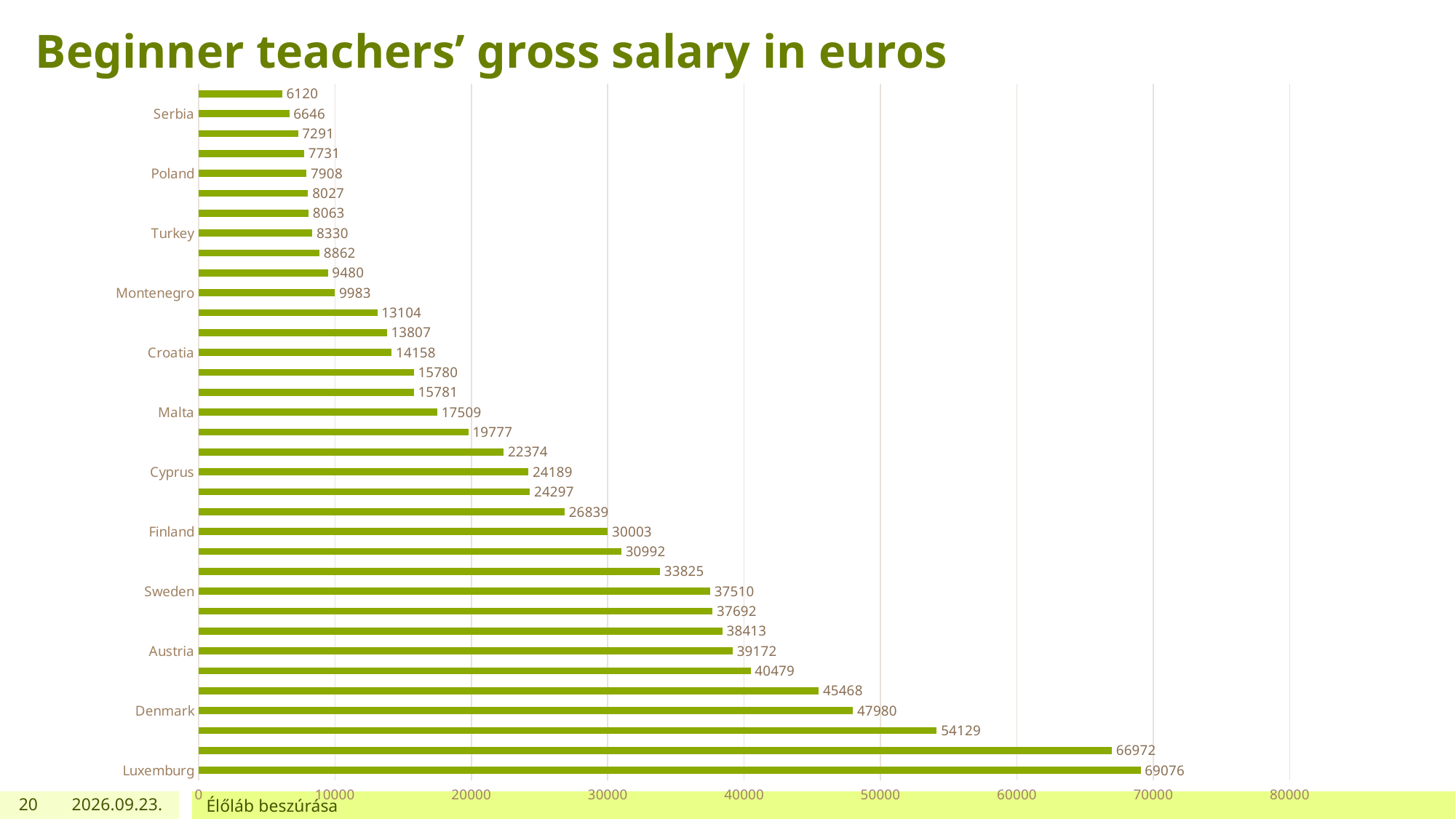
What is the beginner teachers' gross salary in euros for Luxemburg? 69076 What is the smallest value shown on the chart? 6120 What type of chart is shown on the slide? bar chart What is the title of the chart? Beginner teachers' gross salary in euros Which labelled country has the highest beginner teachers' gross salary? Luxemburg Which has a higher value, Cyprus or Malta? Cyprus What is the value shown for Serbia? 6646 Is the value for Croatia greater or less than 10000? greater What is the value shown for Denmark? 47980 What is the value shown for Finland? 30003 What is the difference between the values for Austria and Sweden? 1662 How many bars are plotted on the chart? 35